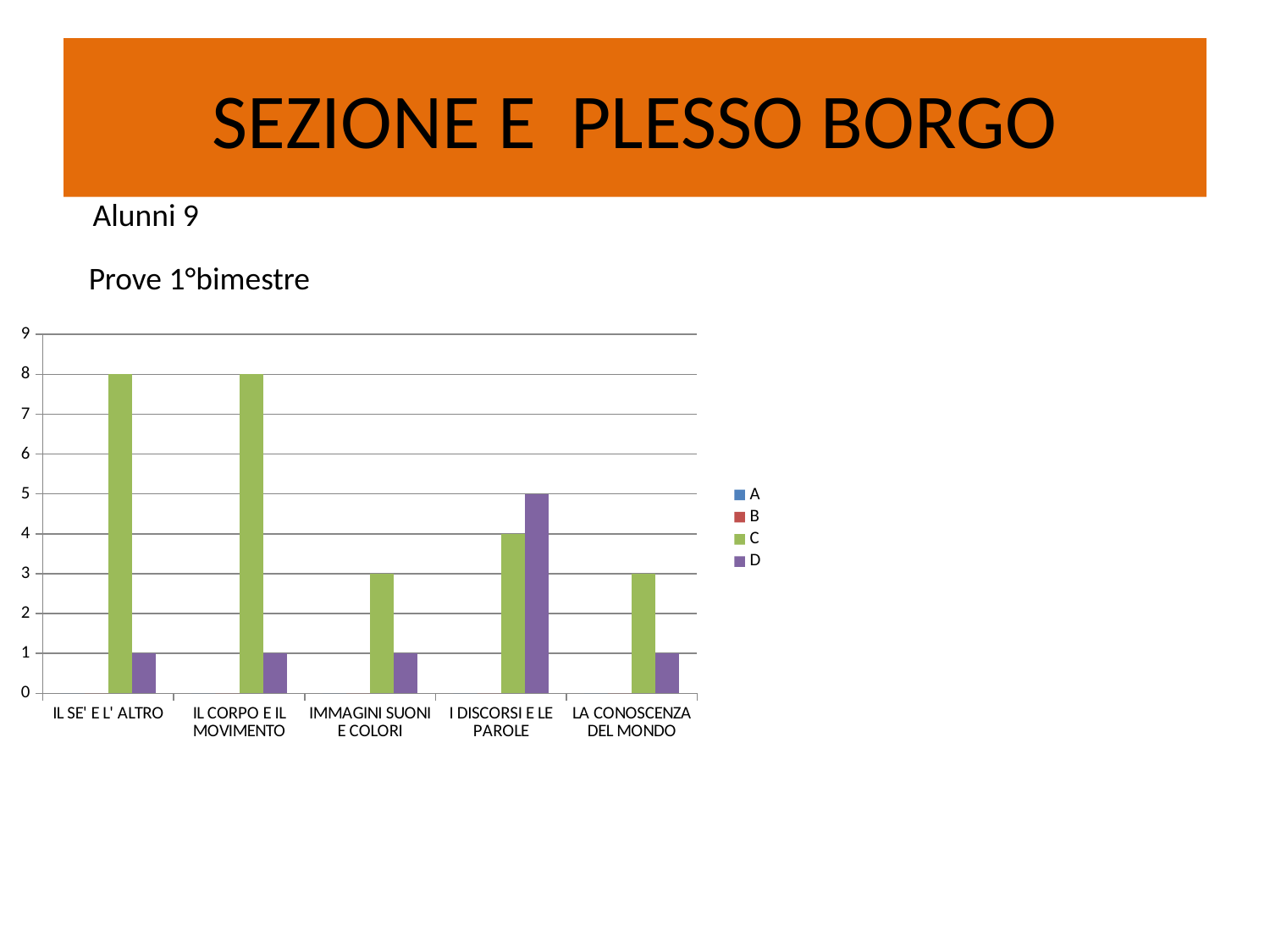
What is the difference between series C and series D for IL CORPO E IL MOVIMENTO? 7 What is the value of series C for IL SE' E L' ALTRO? 8 What kind of chart is shown on the slide? bar chart In which category does series C have its lowest value? IMMAGINI SUONI E COLORI and LA CONOSCENZA DEL MONDO What is the value of series C for IMMAGINI SUONI E COLORI? 3 Which legend entries have no visible bars in the chart? A and B In which category does series D reach its highest value? I DISCORSI E LE PAROLE For I DISCORSI E LE PAROLE, which is larger, series C or series D? D How many series does the legend list? 4 What is the value of series D for LA CONOSCENZA DEL MONDO? 1 What is the value of series D for I DISCORSI E LE PAROLE? 5 How many categories are shown on the x axis? 5